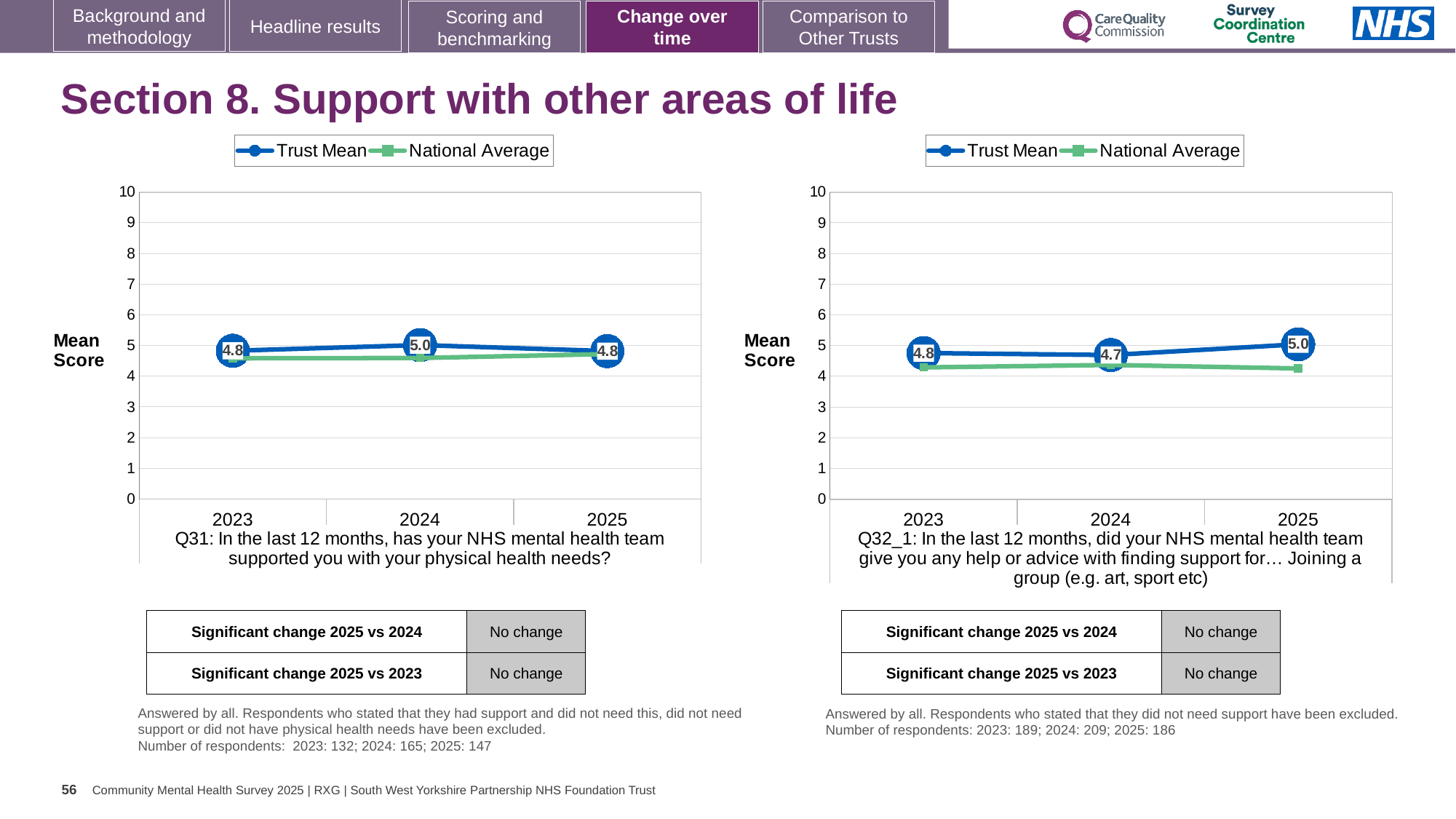
In the Q31 chart on the left, what is the Trust Mean score for 2024? 5.0 In the Q32_1 chart on the right, which is larger in 2025: the Trust Mean or the National Average? Trust Mean In the Q31 chart on the left, what is the Trust Mean score for 2025? 4.8 In the Q31 chart on the left, which year has the highest Trust Mean score? 2024 How many series does the legend of the Q32_1 chart on the right list? 2 What kind of chart is the Q31 chart on the left? Line chart In the Q32_1 chart on the right, what is the Trust Mean score for 2024? 4.7 In the Q32_1 chart on the right, which year has the lowest Trust Mean score? 2024 In the Q32_1 chart on the right, what is the difference between the Trust Mean scores for 2025 and 2024? 0.3 In the Q32_1 chart on the right, what is the Trust Mean score for 2025? 5.0 In the Q31 chart on the left, is the National Average value for 2023 greater or less than 5? less How many years are plotted on the x axis of the Q31 chart on the left? 3